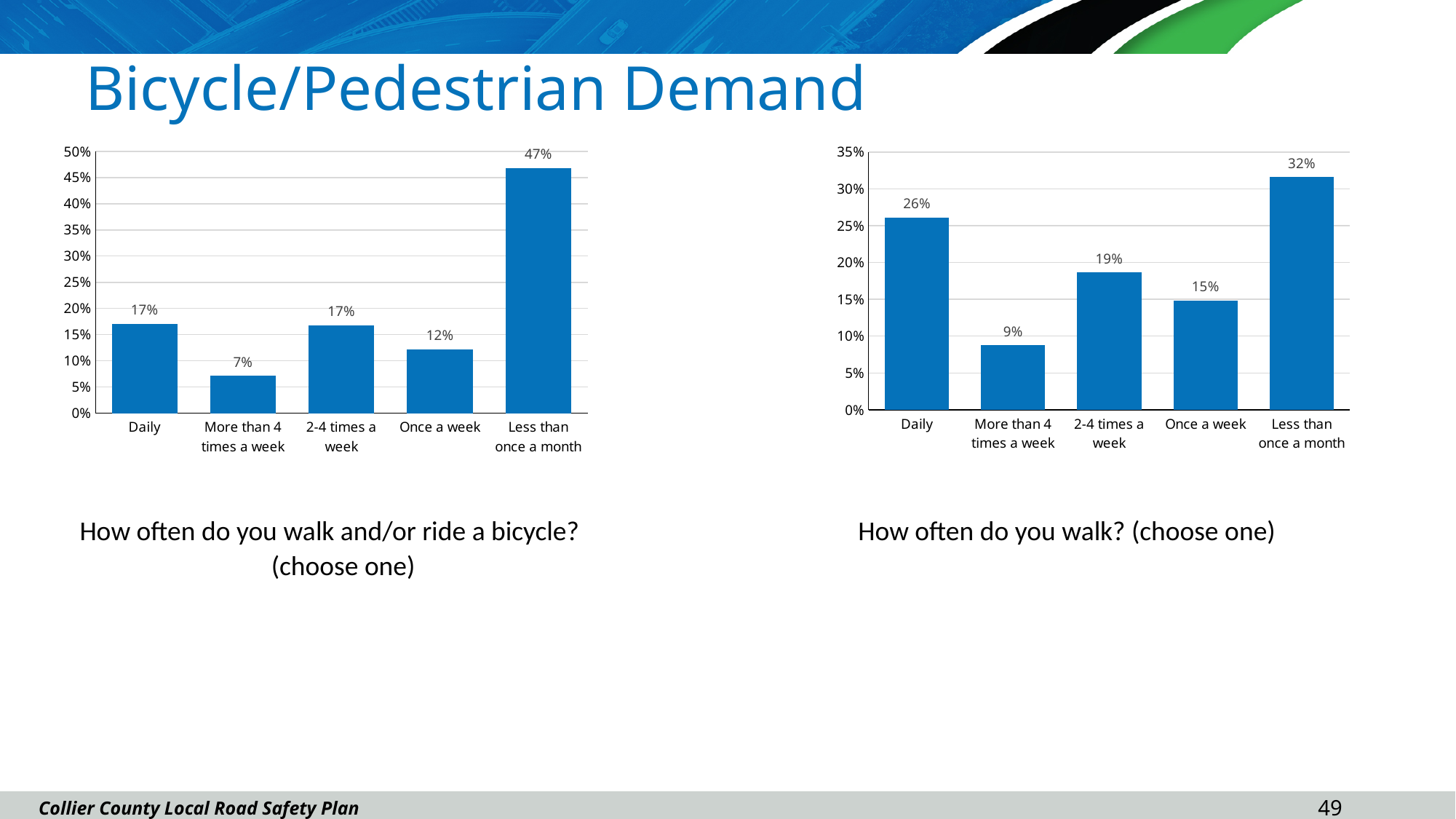
What is the title of the slide? Bicycle/Pedestrian Demand In the right chart (How often do you walk?), which category has the lowest value? More than 4 times a week What kind of chart is the right chart (How often do you walk?)? Bar chart In the left chart (How often do you walk and/or ride a bicycle?), what is the value for 'Less than once a month'? 47% In the right chart (How often do you walk?), what is the difference between 'Less than once a month' and 'Daily'? 6% In the right chart (How often do you walk?), what is the value for 'Daily'? 26% How many categories are shown in the left chart (How often do you walk and/or ride a bicycle?)? 5 In the left chart (How often do you walk and/or ride a bicycle?), what is the value for 'More than 4 times a week'? 7% In the right chart (How often do you walk?), which is larger: 'Daily' or 'Once a week'? Daily In the left chart (How often do you walk and/or ride a bicycle?), which category has the highest value? Less than once a month In the left chart (How often do you walk and/or ride a bicycle?), what is the difference between 'Less than once a month' and 'Once a week'? 35% In the right chart (How often do you walk?), what is the value for '2-4 times a week'? 19%